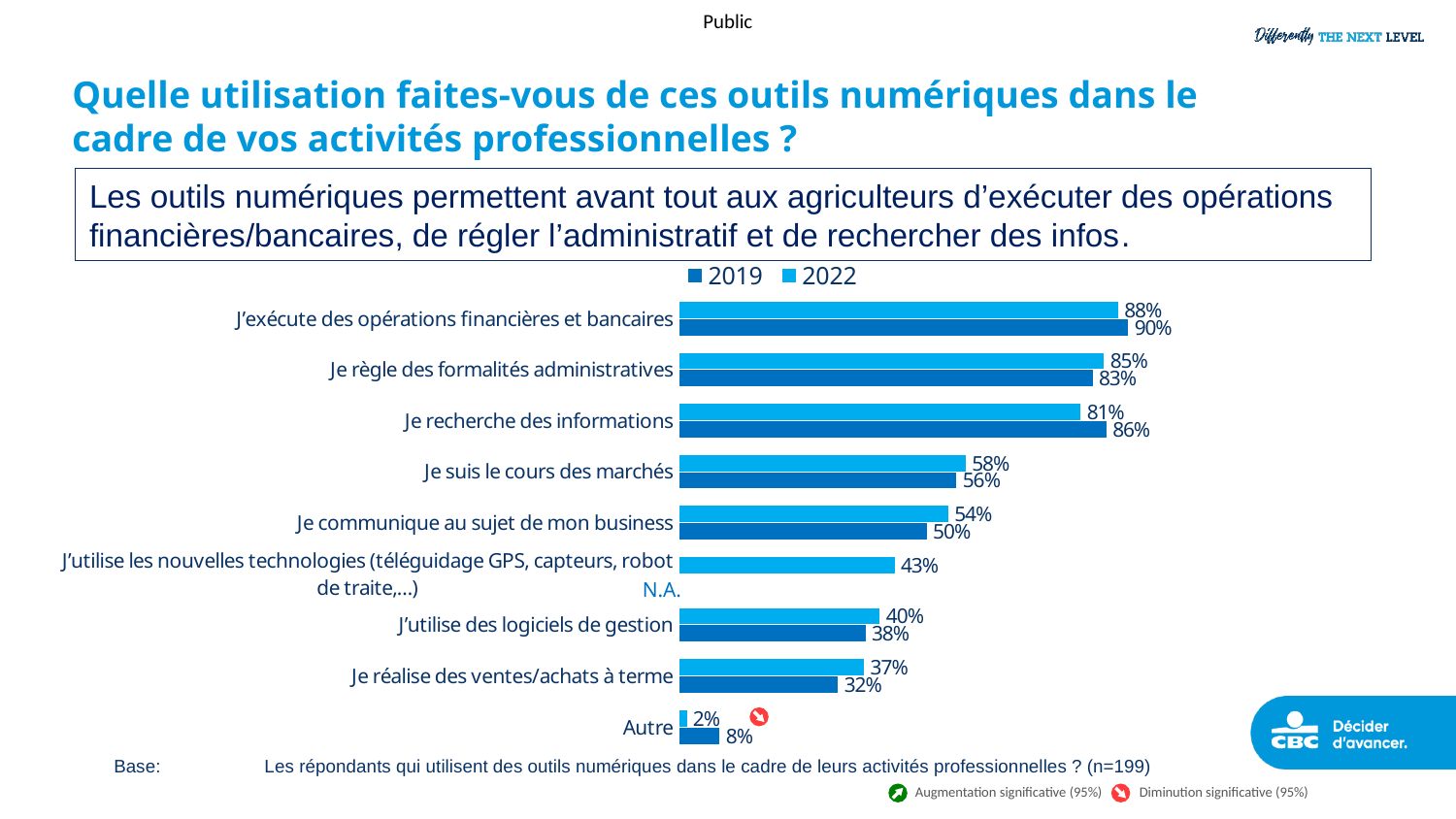
What is the 2022 value for "Je recherche des informations"? 81% Which category has the lowest 2022 value? Autre What is the 2019 value for "Je suis le cours des marchés"? 56% What kind of chart is shown on the slide? Bar chart What is shown instead of a 2019 value for "J'utilise les nouvelles technologies (téléguidage GPS, capteurs, robot de traite,...)"? N.A. How many categories are plotted on the chart? 9 How many series does the chart legend list? 2 For "Je recherche des informations", which year has the larger value, 2019 or 2022? 2019 What is the 2019 value for "Je réalise des ventes/achats à terme"? 32% What is the difference between the 2019 and 2022 values for "Autre"? 6 percentage points Which category has the highest 2022 value? J'exécute des opérations financières et bancaires What is the 2022 value for "J'utilise les nouvelles technologies (téléguidage GPS, capteurs, robot de traite,...)"? 43%